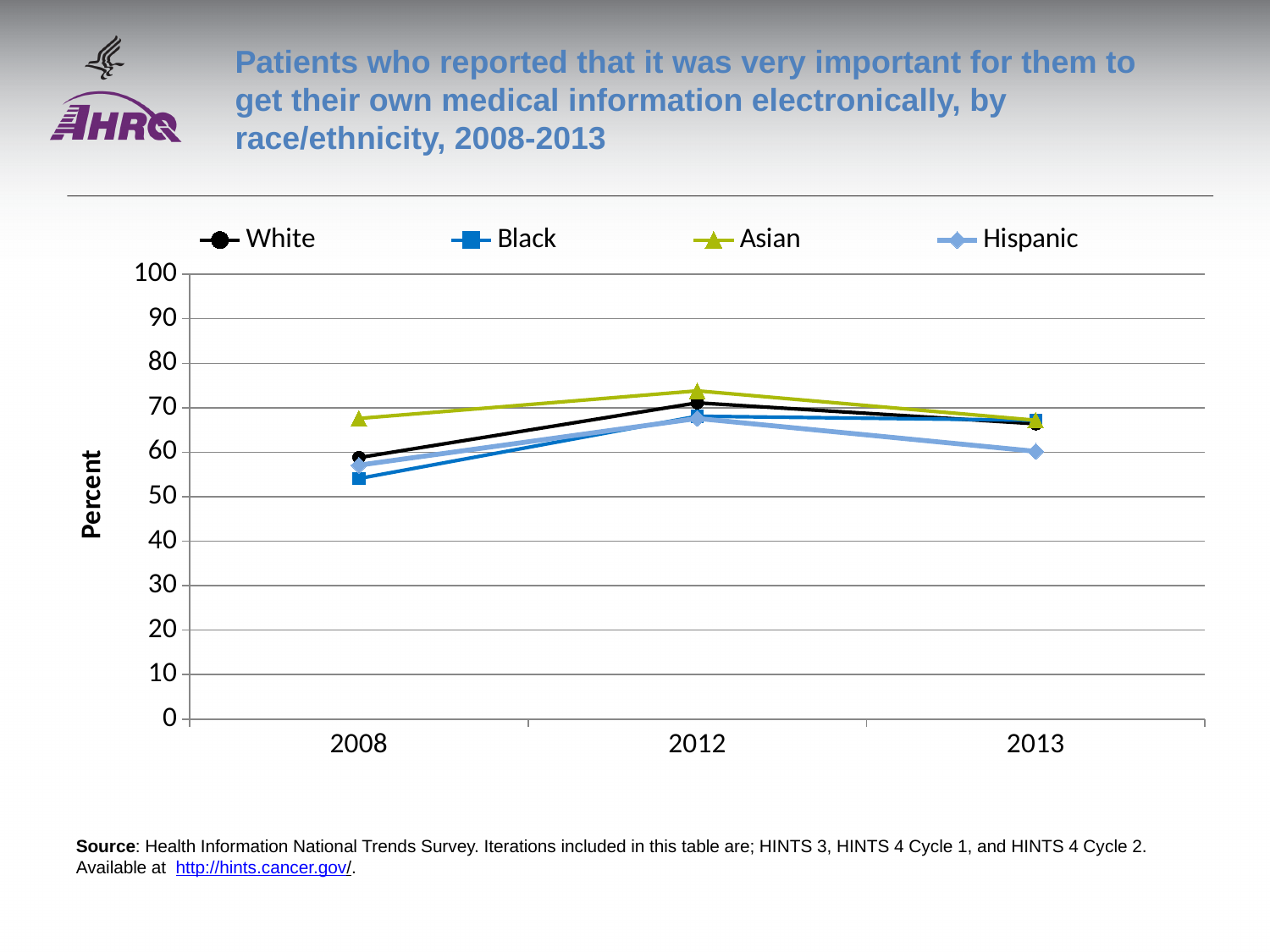
How many series does the legend list? 4 In 2008, which was larger, the value for Asian or the value for Black? Asian Is the value for Asian in 2008 greater or less than 60? greater What is the label on the y axis? Percent Is the value for Black in 2008 greater or less than 60? less Which race/ethnicity group had the highest value in 2012? Asian What kind of chart is shown on the slide? Line chart Which race/ethnicity group had the highest value in 2008? Asian How many years are shown on the x axis? 3 Did the value for Hispanic rise or fall from 2012 to 2013? Fall Is the value for Hispanic in 2013 greater or less than 70? less Which race/ethnicity group had the lowest value in 2013? Hispanic